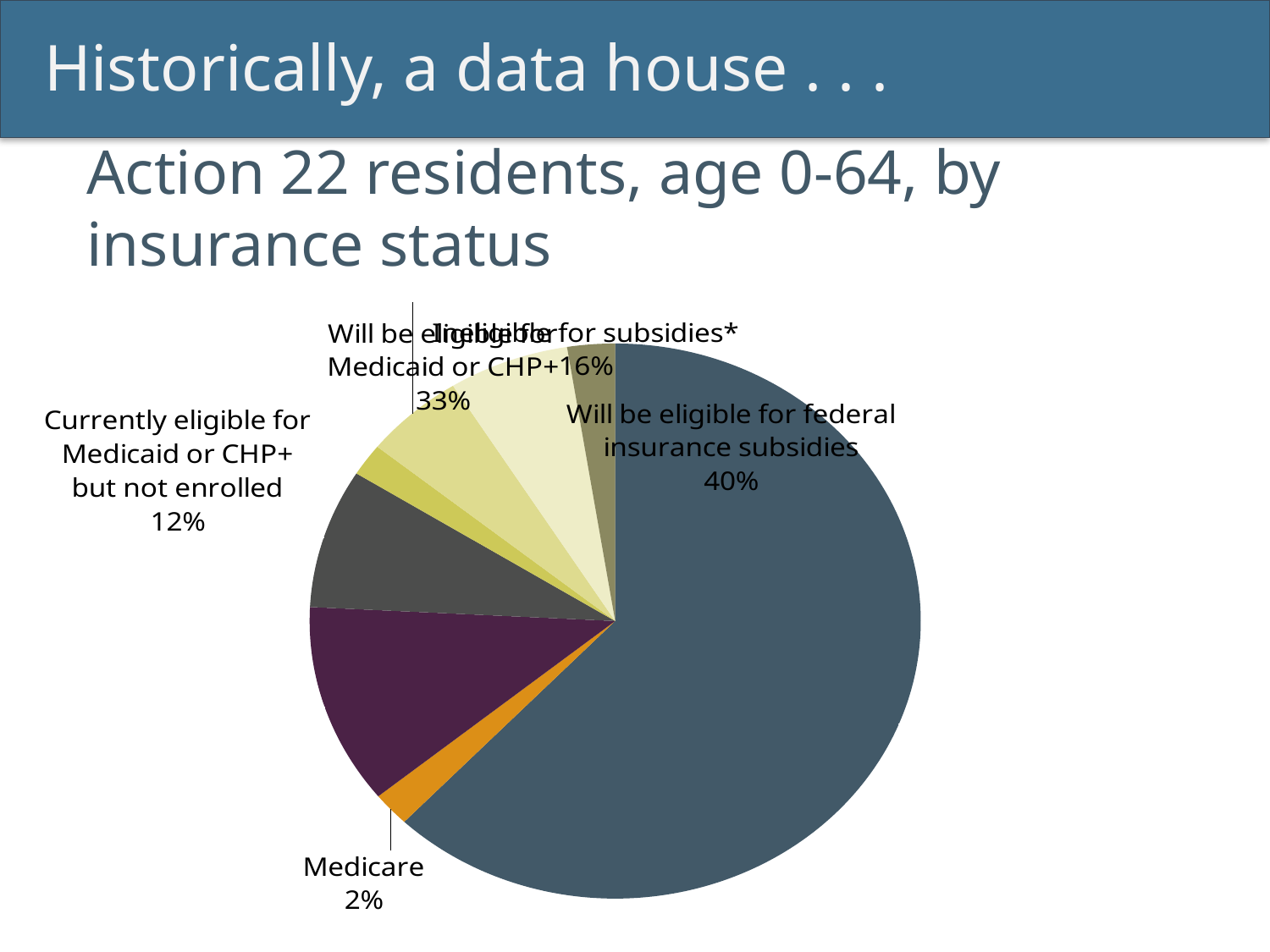
What is the title of the chart? Action 22 residents, age 0-64, by insurance status What share of residents are ineligible for subsidies? 16% Which is larger: the share that will be eligible for federal insurance subsidies or the share that will be eligible for Medicaid or CHP+? Will be eligible for federal insurance subsidies What kind of chart is shown on the slide? pie chart What percentage of residents are on Medicare? 2% What percentage of residents will be eligible for Medicaid or CHP+? 33% Which insurance status category has the smallest share of the pie? Medicare Which insurance status category has the largest share of the pie? Will be eligible for federal insurance subsidies Which is larger: the share currently eligible for Medicaid or CHP+ but not enrolled, or the share ineligible for subsidies? Ineligible for subsidies What is the difference in percentage points between the federal insurance subsidies share and the Medicare share? 38 percentage points What share of residents will be eligible for federal insurance subsidies? 40% What share of residents are currently eligible for Medicaid or CHP+ but not enrolled? 12%